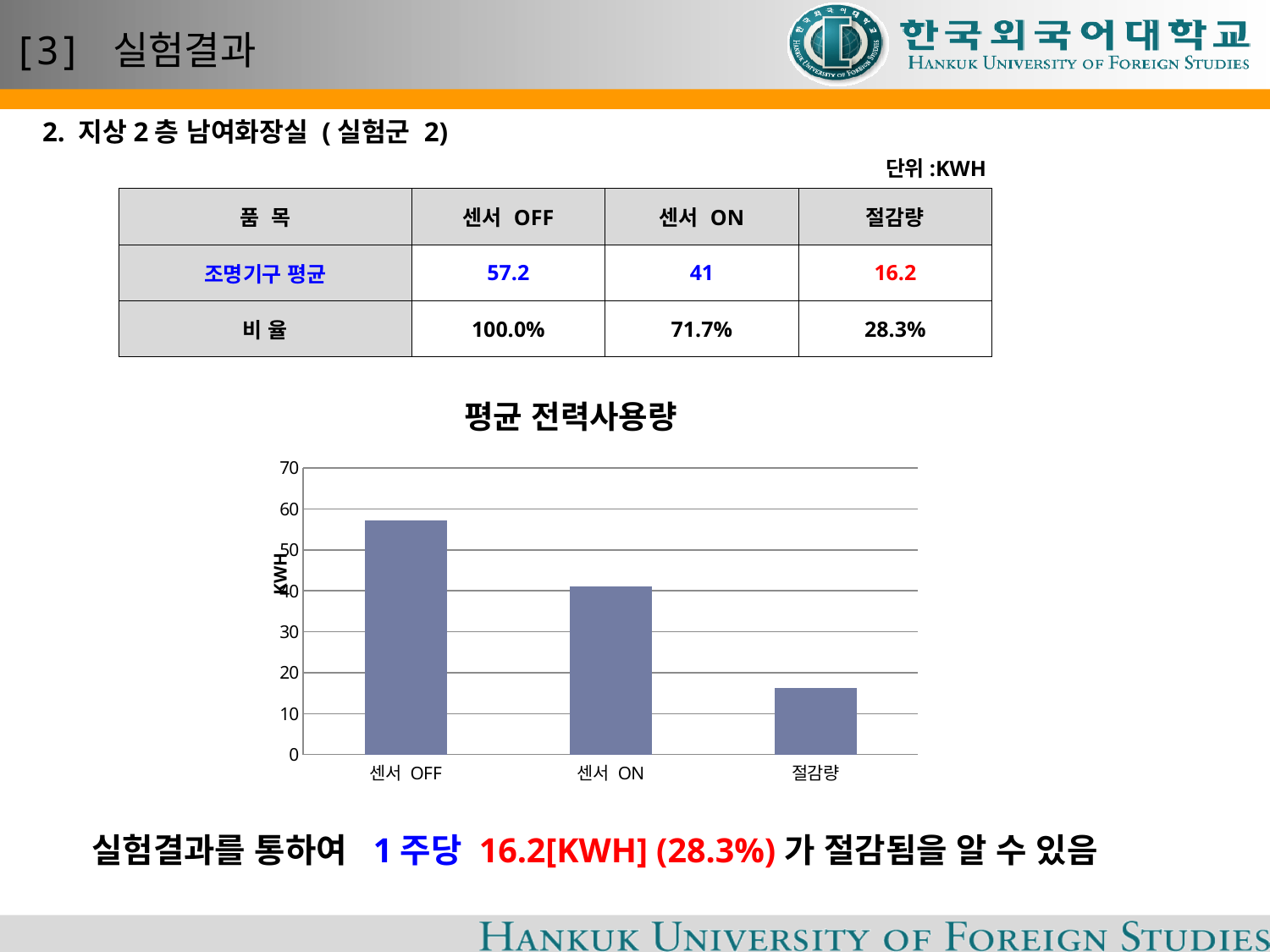
How many categories are plotted on the x axis of the 평균 전력사용량 chart? 3 What kind of chart is shown under the title 평균 전력사용량? bar chart Which category has the tallest bar in the 평균 전력사용량 chart? 센서 OFF Which category has the shortest bar in the 평균 전력사용량 chart? 절감량 Do the bar values rise or fall from left to right across the x axis of the 평균 전력사용량 chart? fall What is the label on the vertical axis of the 평균 전력사용량 chart? KWH According to the slide, what is the 절감량 value plotted in the 평균 전력사용량 chart? 16.2 Is the value for 센서 ON in the 평균 전력사용량 chart greater or less than 50? less Is the value for 절감량 in the 평균 전력사용량 chart greater or less than 20? less According to the slide, what is the 조명기구 평균 value for 센서 OFF plotted in the 평균 전력사용량 chart? 57.2 Is the value for 센서 OFF in the 평균 전력사용량 chart greater or less than 50? greater In the 평균 전력사용량 chart, which bar is taller: 센서 OFF or 센서 ON? 센서 OFF